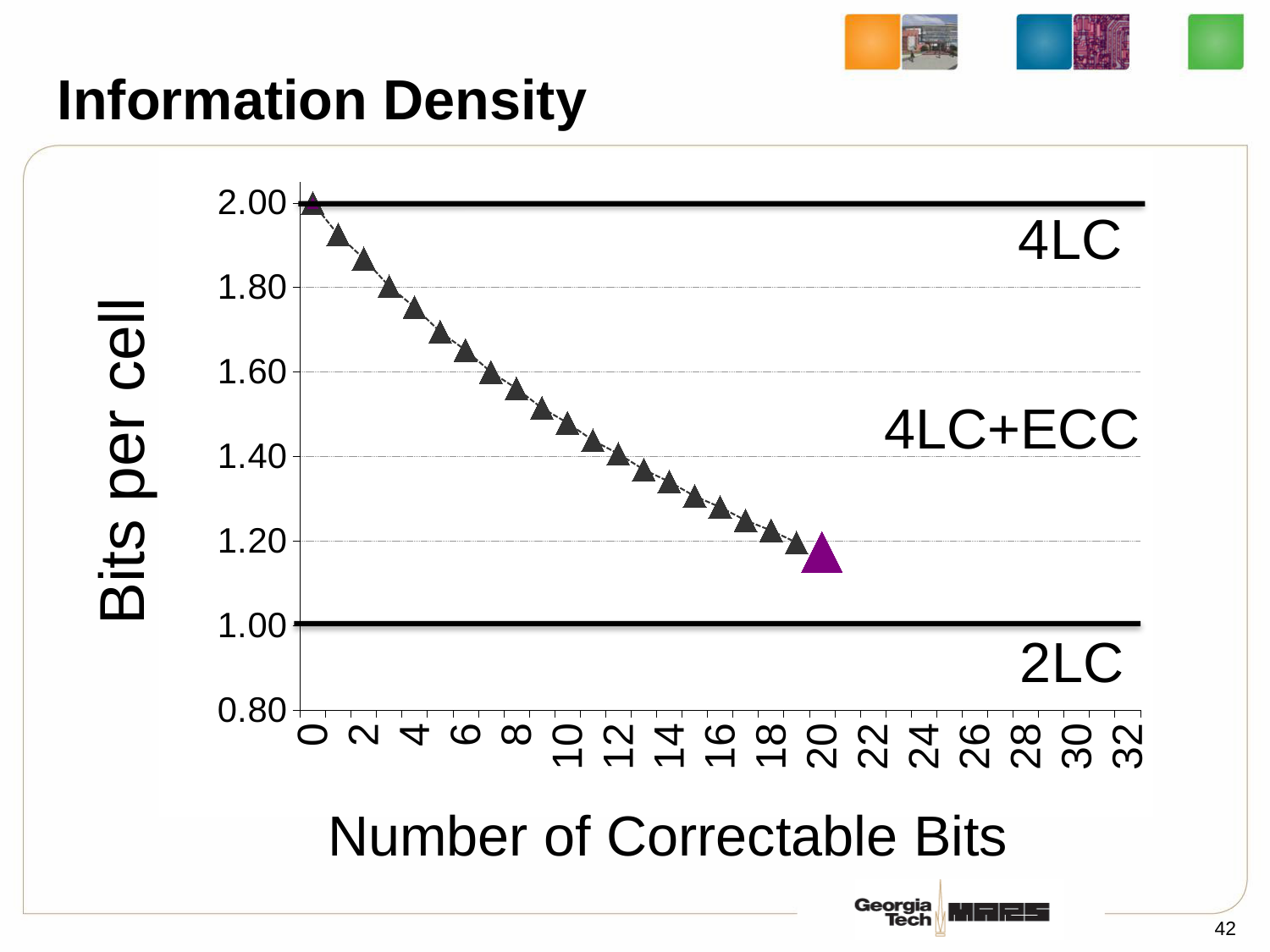
Do the 4LC+ECC values rise or fall as the number of correctable bits increases? fall At which number of correctable bits is the 4LC+ECC value highest? 0 What is the bits per cell value of the 2LC line? 1.00 Is the 4LC+ECC value at 16 correctable bits greater or less than 1.40? less What is the bits per cell value of the 4LC line? 2.00 What kind of chart is shown on the slide? line chart What is the bits per cell value of 4LC+ECC at 0 correctable bits? 2.00 What is the difference in bits per cell between the 4LC line and the 2LC line? 1.00 What is the label of the y axis? Bits per cell What is the label of the x axis? Number of Correctable Bits Which has the higher bits per cell, 4LC or 2LC? 4LC Is the 4LC+ECC value at 10 correctable bits greater or less than 1.40? greater